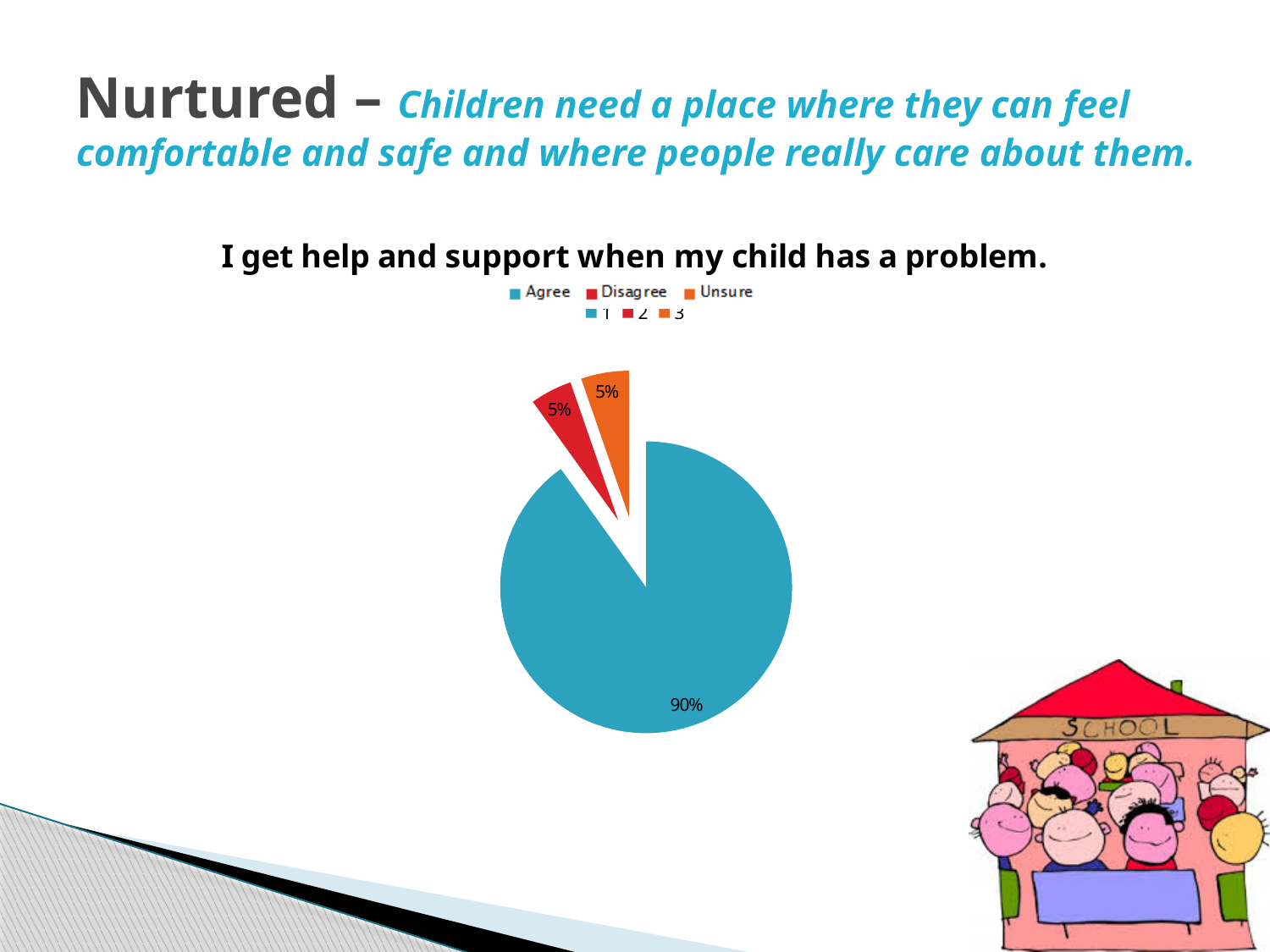
What percentage of respondents chose Agree? 90% What percentage of respondents chose Unsure? 5% How many slices does the pie chart have? 3 Which response has the largest share of the pie? Agree Which is larger, the Agree share or the Unsure share? Agree Which colour represents Agree in the pie chart? blue What is the combined share of Disagree and Unsure? 10% What statement is the pie chart about? I get help and support when my child has a problem. What kind of chart is shown on the slide? pie chart What percentage of respondents chose Disagree? 5% What is the difference between the Agree share and the Disagree share? 85%